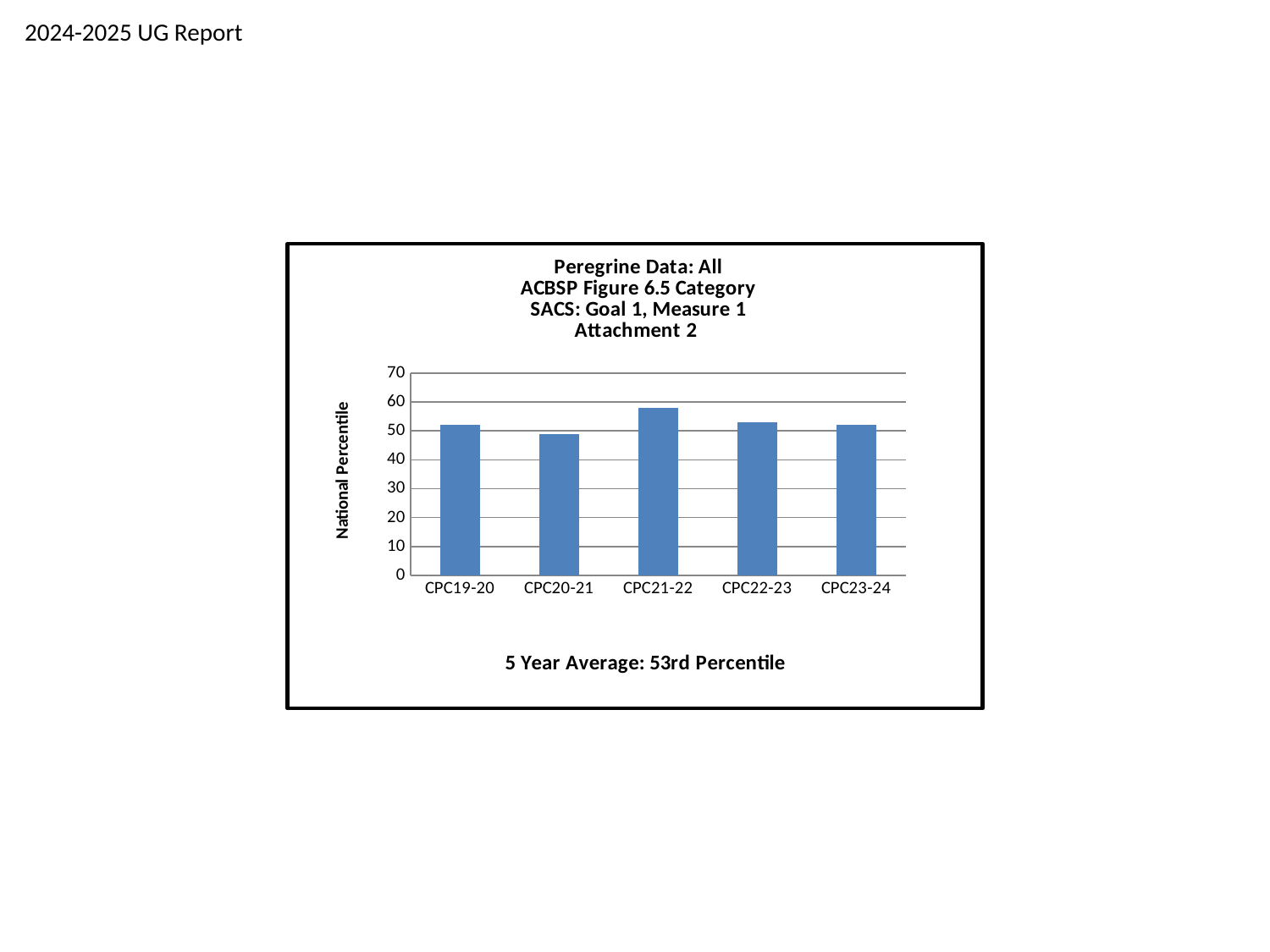
Is the value for CPC20-21 greater or less than 40? greater Is the value for CPC21-22 greater or less than 60? less Is the value for CPC22-23 greater or less than 60? less Which category has the highest national percentile? CPC21-22 Which category has the lowest national percentile? CPC20-21 Which is larger, the value for CPC21-22 or the value for CPC20-21? CPC21-22 What 5 year average is stated below the chart? 53rd Percentile What is the label on the vertical axis of the chart? National Percentile How many categories are plotted on the x axis of the chart? 5 Which is larger, the value for CPC22-23 or the value for CPC20-21? CPC22-23 What kind of chart is shown on the slide? bar chart